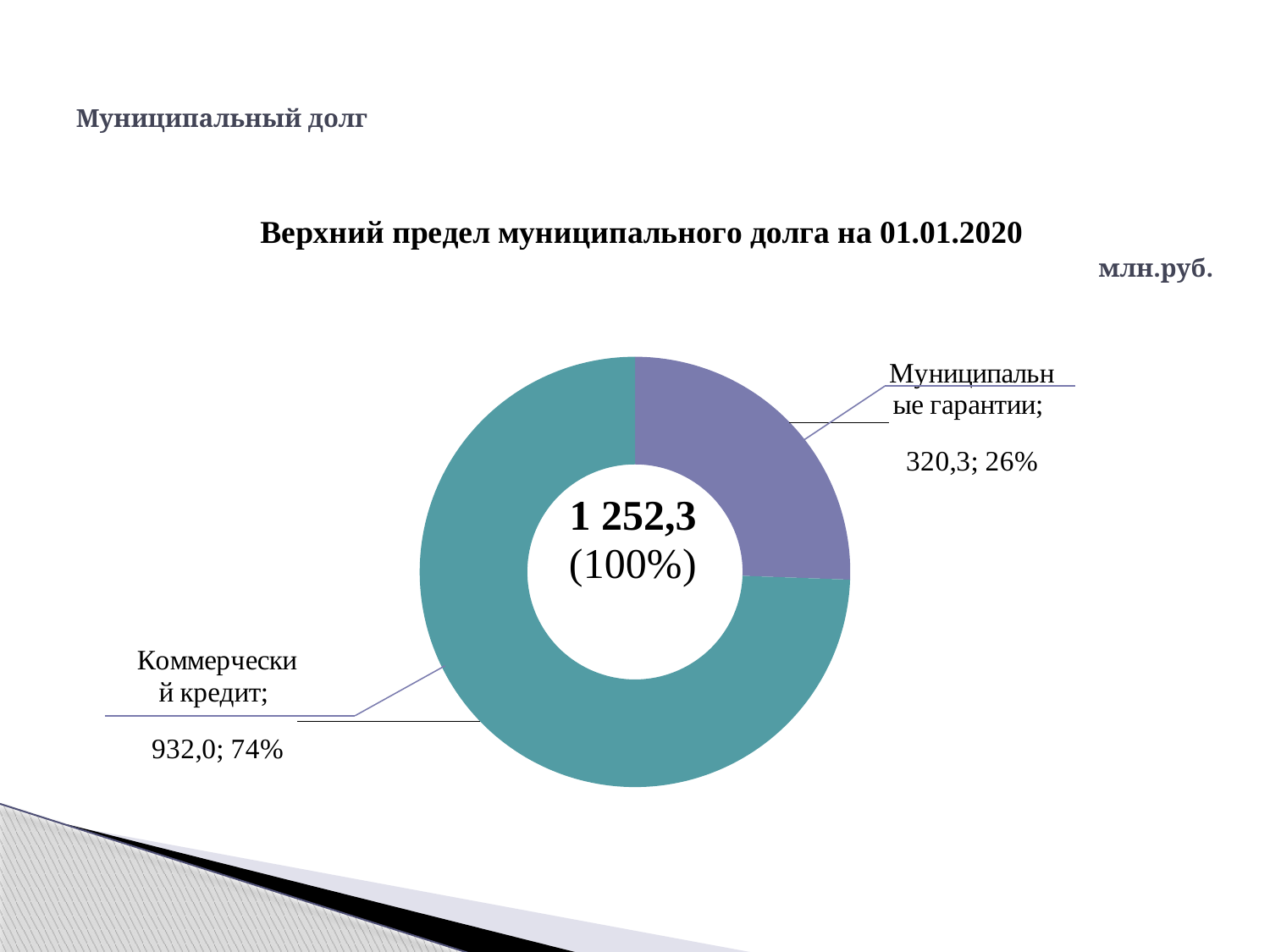
What share of the chart does Муниципальные гарантии represent? 26% What share of the chart does Коммерческий кредит represent? 74% What is the value for Коммерческий кредит? 932,0 Which category has the smallest slice? Муниципальные гарантии How many categories are shown in the chart? 2 What is the title of the chart? Верхний предел муниципального долга на 01.01.2020 Which is larger, Коммерческий кредит or Муниципальные гарантии? Коммерческий кредит What total value is shown in the centre of the chart? 1 252,3 (100%) Which category has the largest slice? Коммерческий кредит What is the difference between the values for Коммерческий кредит and Муниципальные гарантии? 611,7 What type of chart is shown on the slide? Doughnut (pie) chart What is the value for Муниципальные гарантии? 320,3